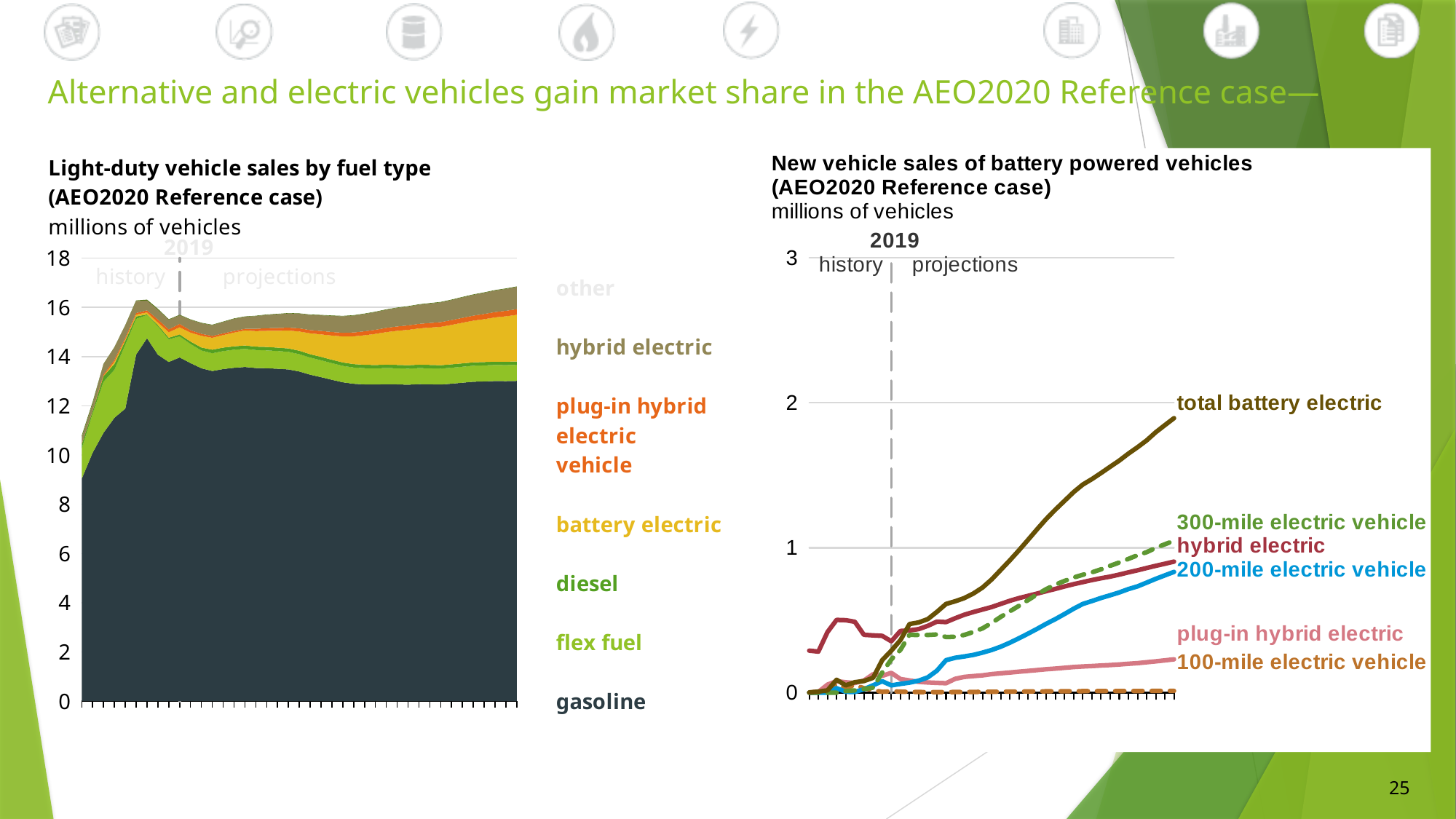
On the right chart, 'New vehicle sales of battery powered vehicles', which series has the highest value at the end of the projection period? total battery electric What kind of chart is the right chart, 'New vehicle sales of battery powered vehicles'? line chart What unit is shown on the y axis of the left chart, 'Light-duty vehicle sales by fuel type'? millions of vehicles On the right chart, 'New vehicle sales of battery powered vehicles', which series has the lowest value at the end of the projection period? 100-mile electric vehicle On the right chart, 'New vehicle sales of battery powered vehicles', does the total battery electric line rise or fall over the projection period? rise On the right chart, 'New vehicle sales of battery powered vehicles', is the value for plug-in hybrid electric at the end of the projection period greater or less than 1? less On the right chart, 'New vehicle sales of battery powered vehicles', is the value for total battery electric at the end of the projection period greater or less than 1? greater On the left chart, 'Light-duty vehicle sales by fuel type', which fuel type accounts for the largest share of sales? gasoline How many series are labelled on the right chart, 'New vehicle sales of battery powered vehicles'? 6 What kind of chart is the left chart, 'Light-duty vehicle sales by fuel type'? stacked area chart How many fuel-type series are labelled on the left chart, 'Light-duty vehicle sales by fuel type'? 7 On the right chart, 'New vehicle sales of battery powered vehicles', at the end of the projection period, which is larger: 300-mile electric vehicle or 100-mile electric vehicle? 300-mile electric vehicle